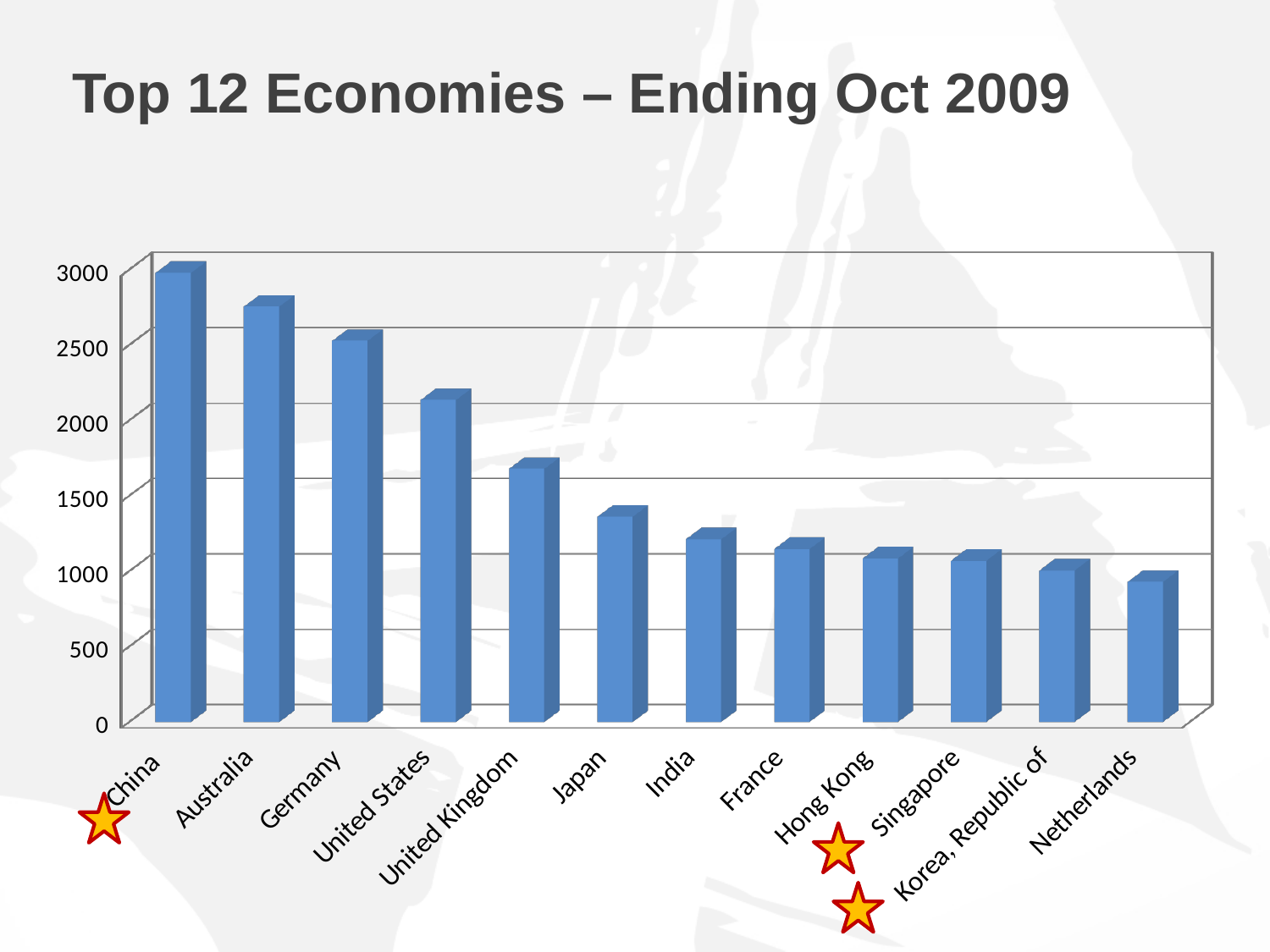
Which has the larger value, Australia or Germany? Australia What kind of chart is shown on the slide? Bar chart Which economy has the highest value on the chart? China Is the value for Japan greater or less than 1500? less Do the values rise or fall moving from left to right along the x axis? Fall Which has the larger value, Japan or India? Japan Which economy has the lowest value on the chart? Netherlands Is the value for Australia greater or less than 2500? greater Is the value for United Kingdom greater or less than 1500? greater How many economies are plotted on the chart? 12 What is the title of the chart? Top 12 Economies – Ending Oct 2009